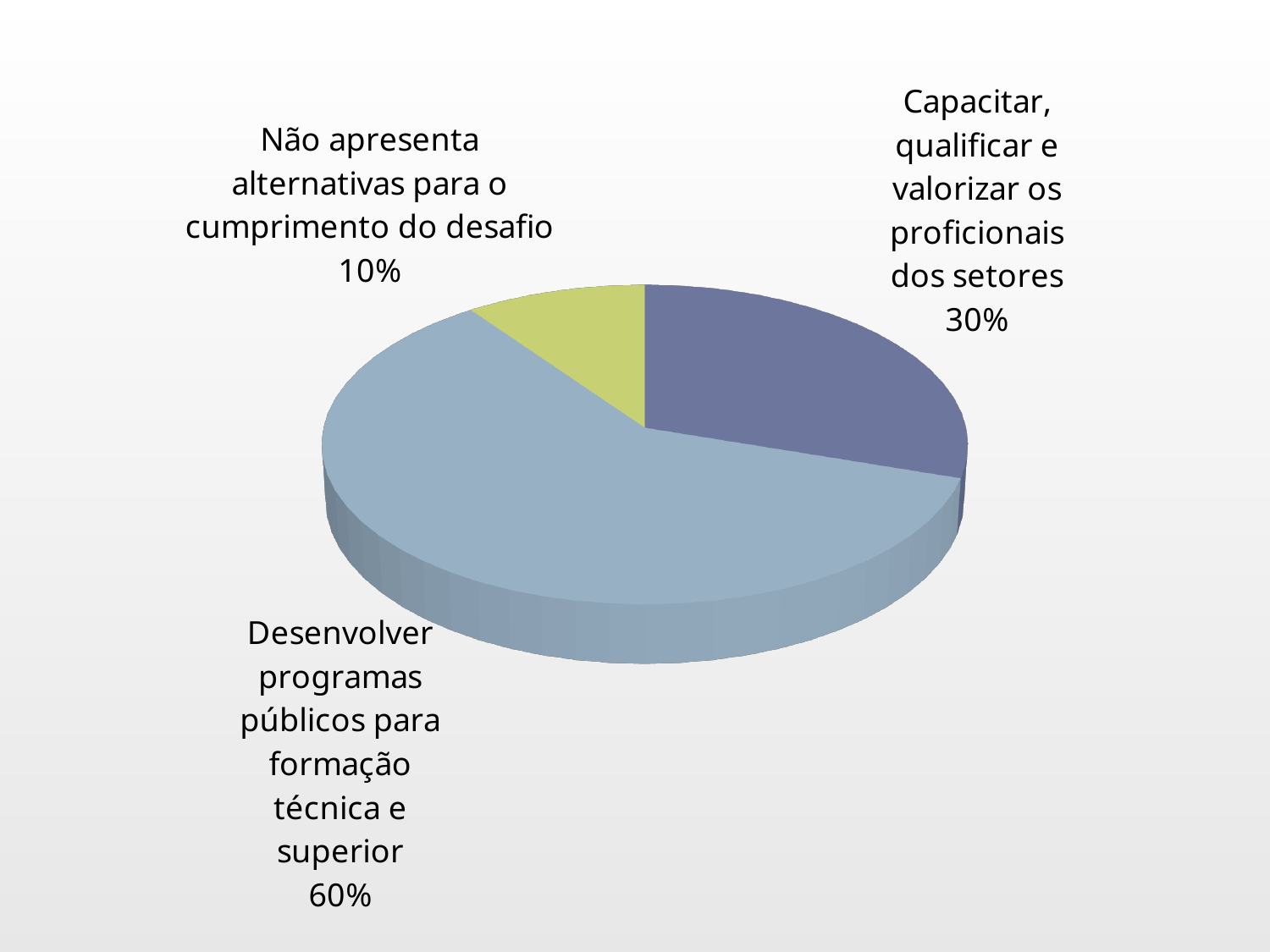
What colour is the slice labelled "Capacitar, qualificar e valorizar os proficionais dos setores"? Dark blue-purple What share of the pie is labelled "Desenvolver programas públicos para formação técnica e superior"? 60% How many slices does the pie chart have? 3 What colour is the slice labelled "Não apresenta alternativas para o cumprimento do desafio"? Yellow-green Which category has the largest slice of the pie? Desenvolver programas públicos para formação técnica e superior What is the difference in percentage points between the "Desenvolver programas públicos para formação técnica e superior" slice and the "Capacitar, qualificar e valorizar os proficionais dos setores" slice? 30% What is the difference in percentage points between the "Capacitar, qualificar e valorizar os proficionais dos setores" slice and the "Não apresenta alternativas para o cumprimento do desafio" slice? 20% What share of the pie is labelled "Capacitar, qualificar e valorizar os proficionais dos setores"? 30% What kind of chart is shown on the slide? Pie chart Which is larger: the "Capacitar, qualificar e valorizar os proficionais dos setores" slice or the "Não apresenta alternativas para o cumprimento do desafio" slice? Capacitar, qualificar e valorizar os proficionais dos setores What share of the pie is labelled "Não apresenta alternativas para o cumprimento do desafio"? 10% Which category has the smallest slice of the pie? Não apresenta alternativas para o cumprimento do desafio